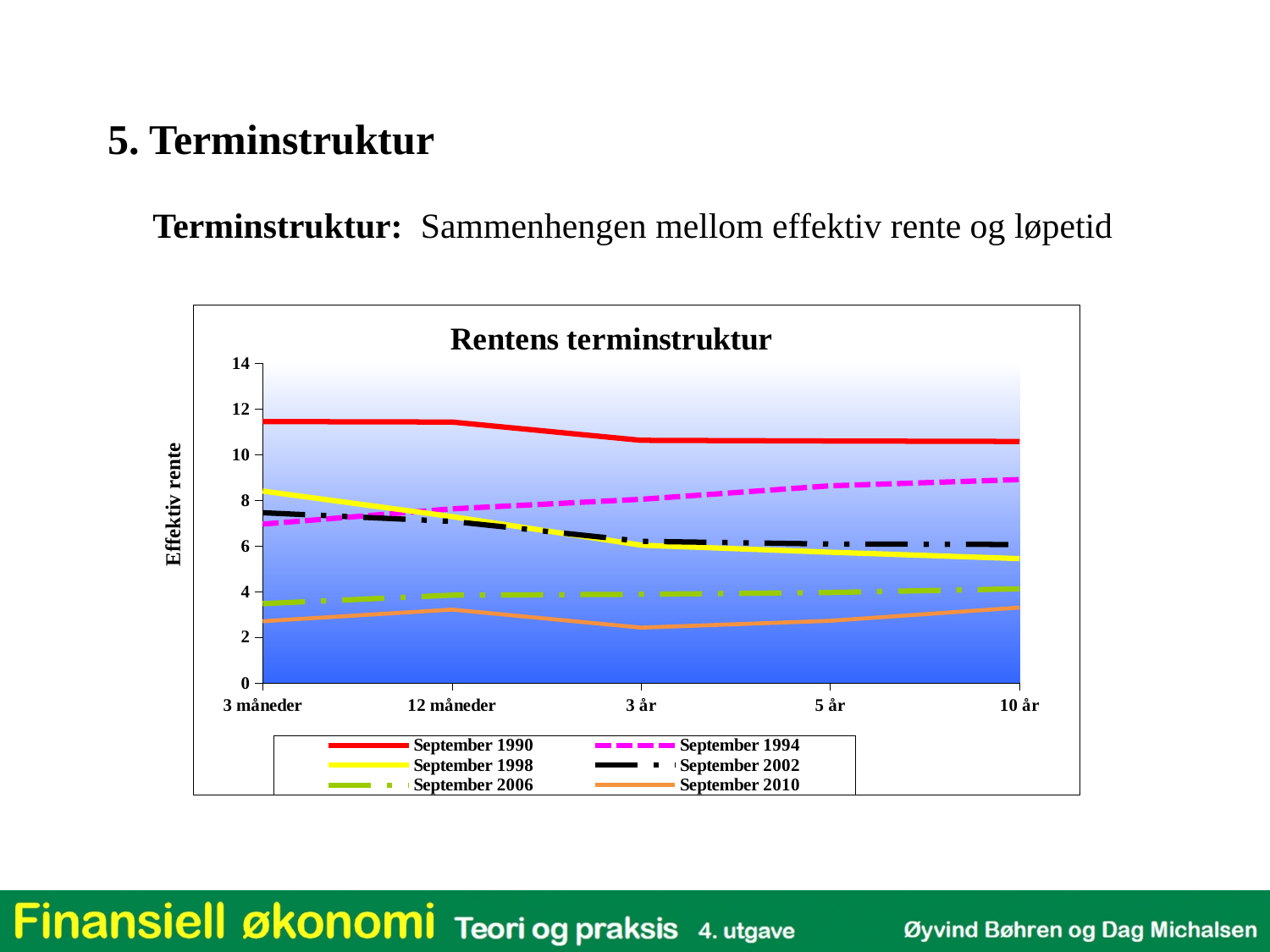
How many maturity categories are shown on the x axis of the chart? 5 Which series has the lowest value at 10 år? September 2010 At 10 år, which is larger: the value for September 1994 or September 1998? September 1994 What is the title of the chart? Rentens terminstruktur Is the value for September 2010 at 3 år greater or less than 4? less Does the September 1994 line rise or fall from 3 måneder to 10 år? rise What is the label of the vertical axis of the chart? Effektiv rente How many series does the legend of the chart list? 6 What kind of chart is shown on the slide? line chart Is the value for September 1990 at 3 måneder greater or less than 10? greater Which series has the highest value at 3 måneder? September 1990 Does the September 1998 line rise or fall from 3 måneder to 10 år? fall